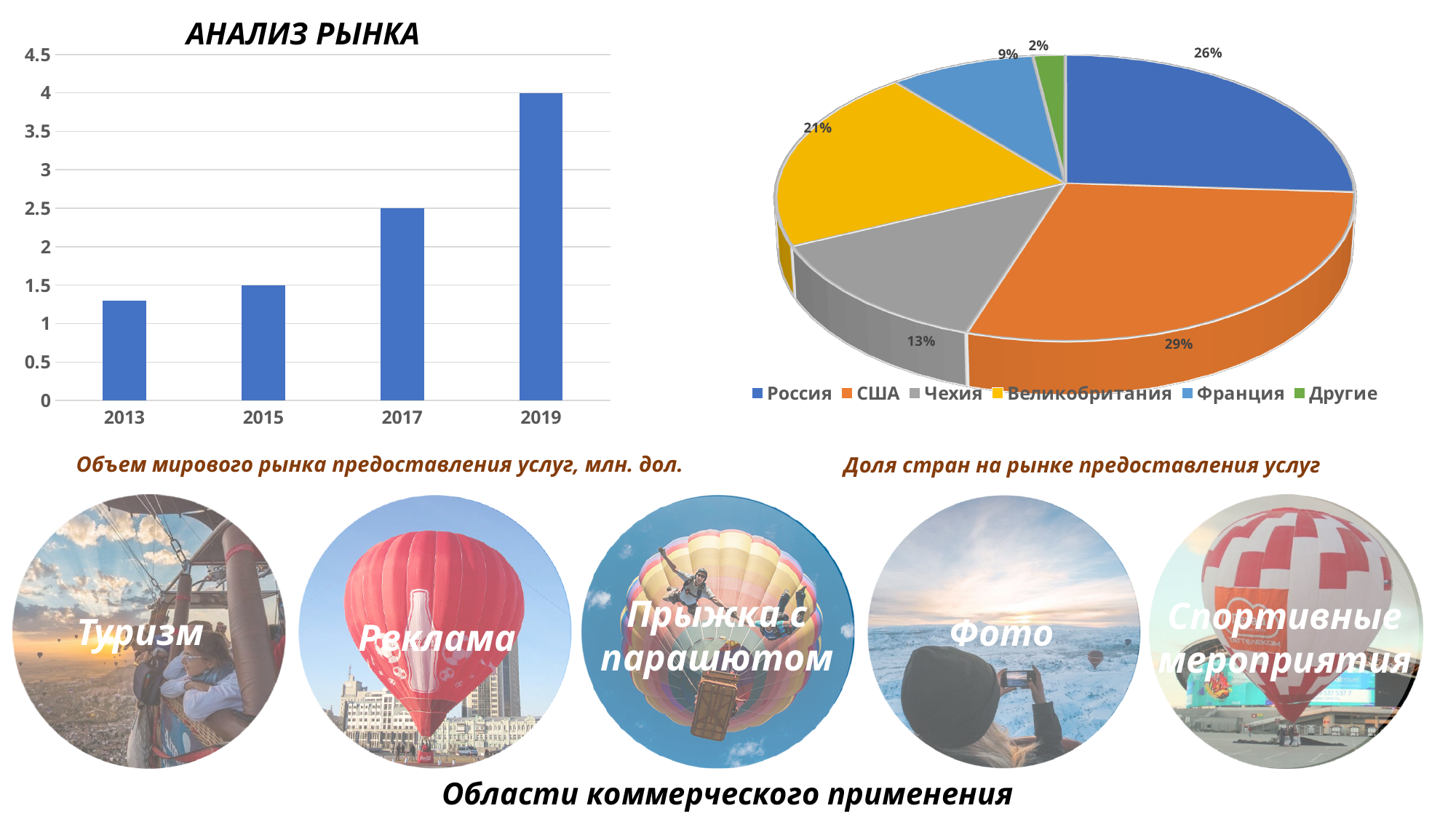
In the bar chart on the left, what is the difference between the values for 2019 and 2015? 2.5 How many entries does the legend of the pie chart on the right list? 6 In the bar chart on the left, which year has the highest value? 2019 In the pie chart on the right, which is larger, the share for Чехия or the share for Великобритания? Великобритания In the bar chart on the left, is the value for 2013 greater or less than 1.5? less In the bar chart on the left, what is the value for 2017? 2.5 In the bar chart on the left, do the values rise or fall from 2013 to 2019? rise In the pie chart on the right, what share does США have? 29% How many years are shown in the bar chart on the left? 4 In the pie chart on the right, which country has the largest share? США In the bar chart on the left, what is the value for 2019? 4 In the bar chart on the left, which year has the lowest value? 2013